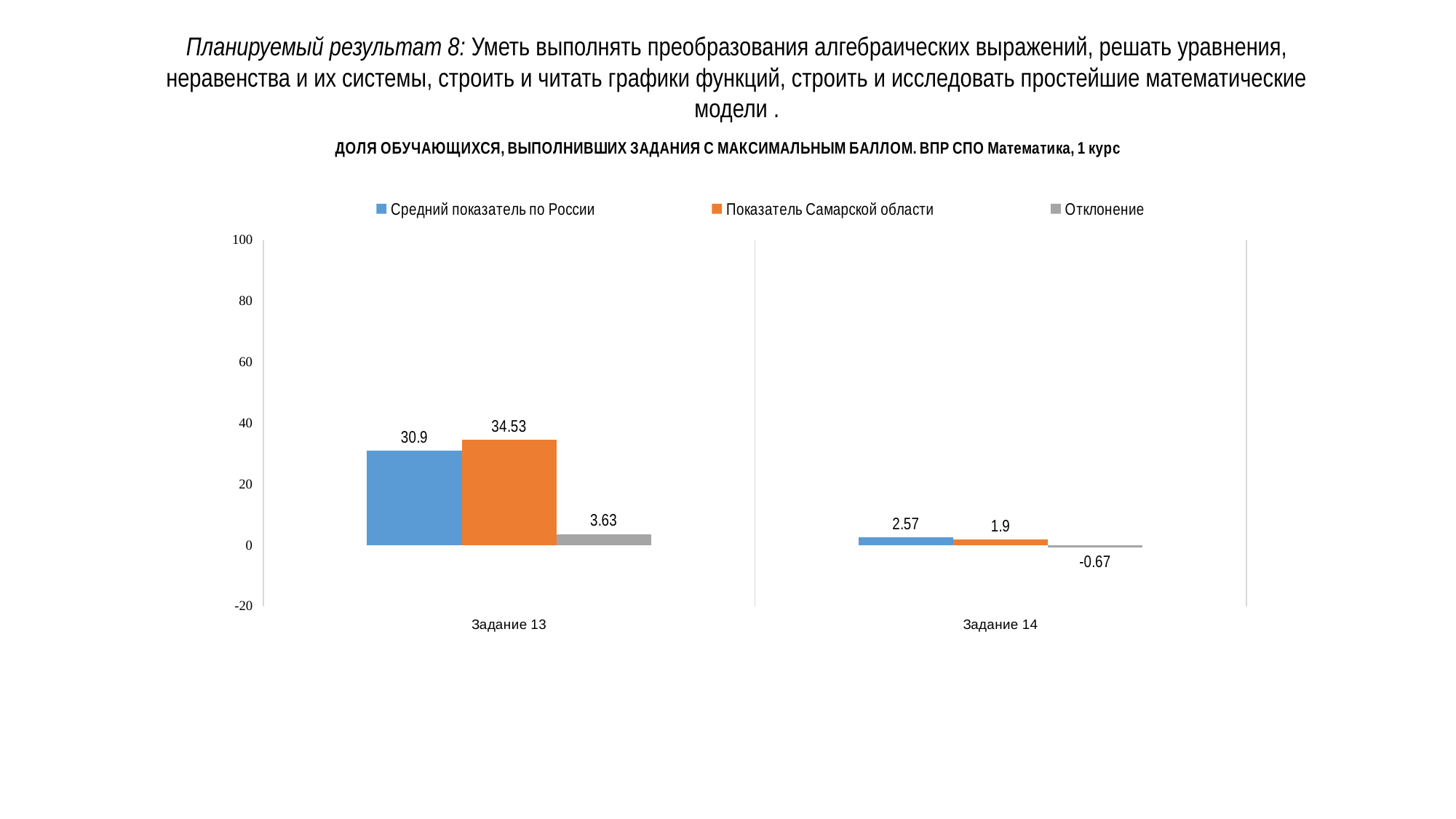
What is the difference between Показатель Самарской области and Средний показатель по России for Задание 13? 3.63 What is the value of Показатель Самарской области for Задание 13? 34.53 What kind of chart is shown on the slide? Bar chart Which series is shown in orange in the legend? Показатель Самарской области What is the value of Отклонение for Задание 14? -0.67 What is the value of Средний показатель по России for Задание 13? 30.9 How many categories are shown on the x axis? 2 For Задание 14, which is larger: Средний показатель по России or Показатель Самарской области? Средний показатель по России What is the value of Показатель Самарской области for Задание 14? 1.9 Is the value of Показатель Самарской области for Задание 13 greater or less than 20? greater How many series does the legend list? 3 Which category has the higher value for Средний показатель по России, Задание 13 or Задание 14? Задание 13